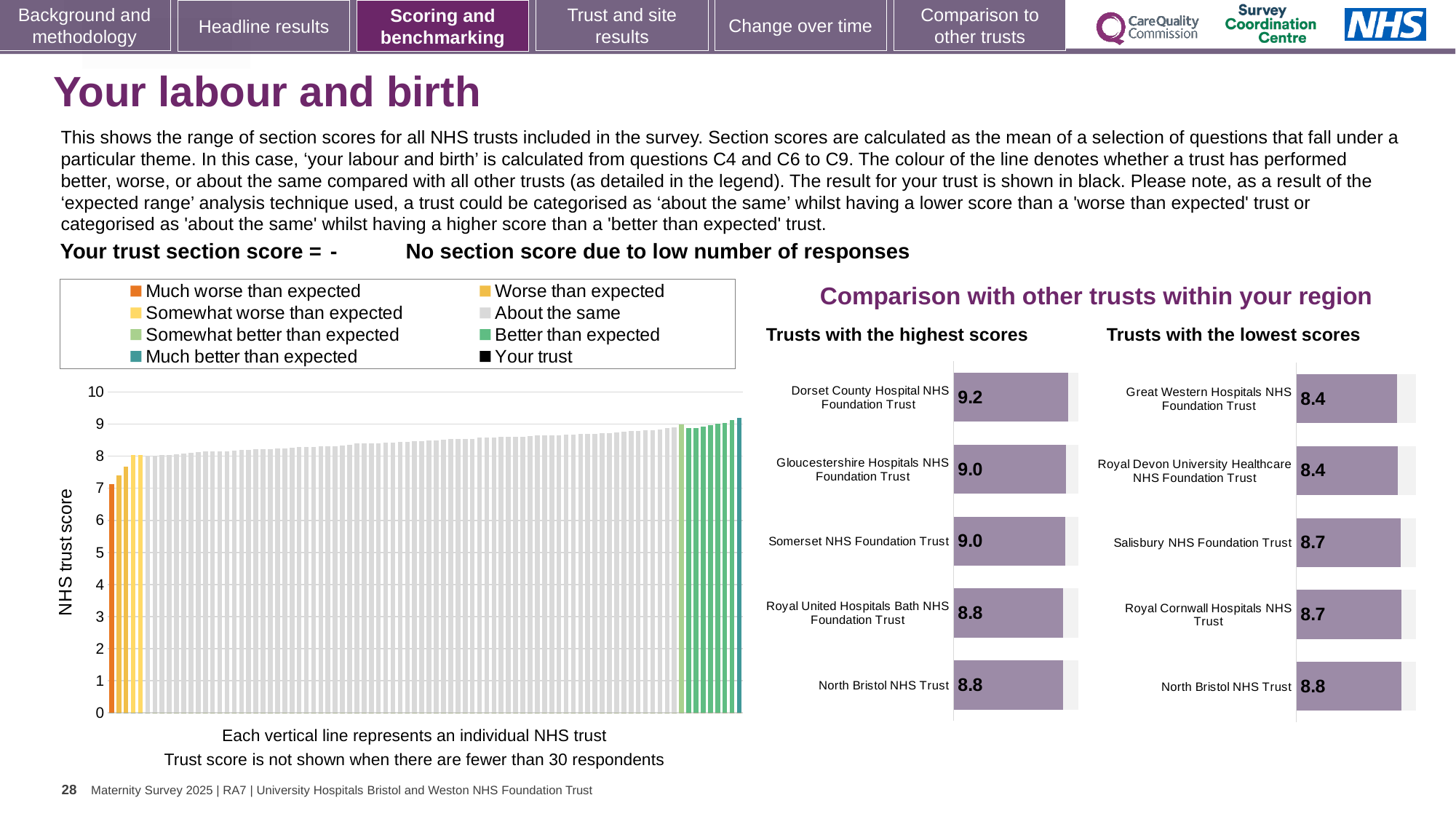
In the 'Trusts with the highest scores' chart, which trust has the highest score? Dorset County Hospital NHS Foundation Trust In the 'Trusts with the lowest scores' chart, what is the score for Great Western Hospitals NHS Foundation Trust? 8.4 In the 'Trusts with the lowest scores' chart, which has the larger score: Salisbury NHS Foundation Trust or Royal Devon University Healthcare NHS Foundation Trust? Salisbury NHS Foundation Trust In the 'Trusts with the lowest scores' chart, which trust has the highest score shown? North Bristol NHS Trust How many entries does the legend of the large chart on the left list? 8 In the 'Trusts with the highest scores' chart, what is the score for Royal United Hospitals Bath NHS Foundation Trust? 8.8 In the large chart on the left, do the NHS trust scores rise or fall from left to right? Rise In the 'Trusts with the highest scores' chart, what is the difference between the scores of Dorset County Hospital NHS Foundation Trust and North Bristol NHS Trust? 0.4 How many trusts are listed in the 'Trusts with the highest scores' chart? 5 In the 'Trusts with the highest scores' chart, what is the score for Dorset County Hospital NHS Foundation Trust? 9.2 What kind of chart is the large chart on the left showing NHS trust scores? Bar chart In the 'Trusts with the lowest scores' chart, what is the score for Salisbury NHS Foundation Trust? 8.7